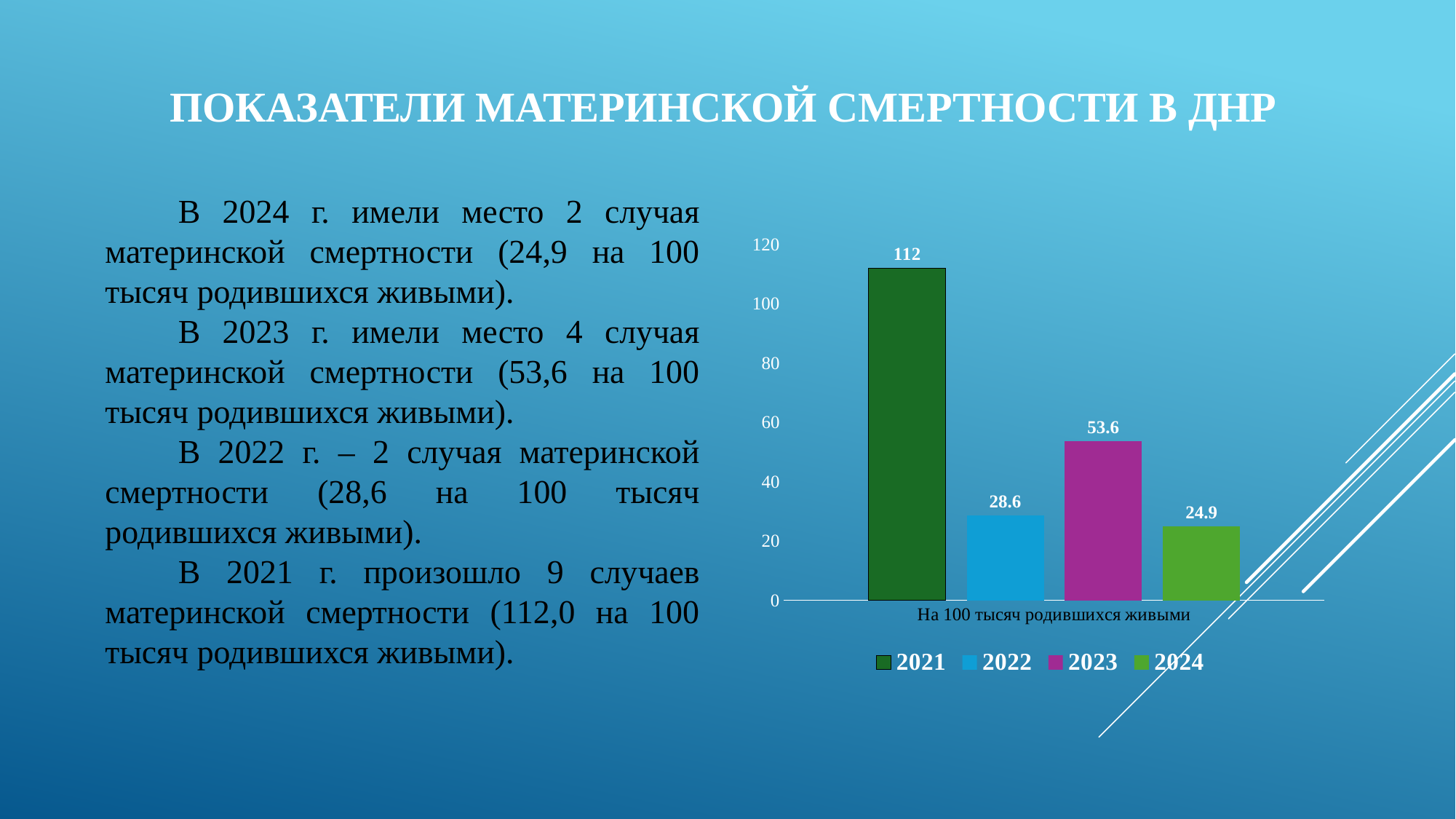
Is the value for 2021 greater or less than 100? greater What is the value for 2022 in the chart? 28.6 What is the value for 2024 in the chart? 24.9 Which year has the lowest value in the chart? 2024 Which year has the highest value in the chart? 2021 What kind of chart is shown on the slide? bar chart What is the value for 2021 in the chart? 112 What is the value for 2023 in the chart? 53.6 How many series does the legend list? 4 What is the label on the x axis under the bars? На 100 тысяч родившихся живыми What is the difference between the values for 2021 and 2023? 58.4 Which is larger, the value for 2022 or the value for 2023? 2023